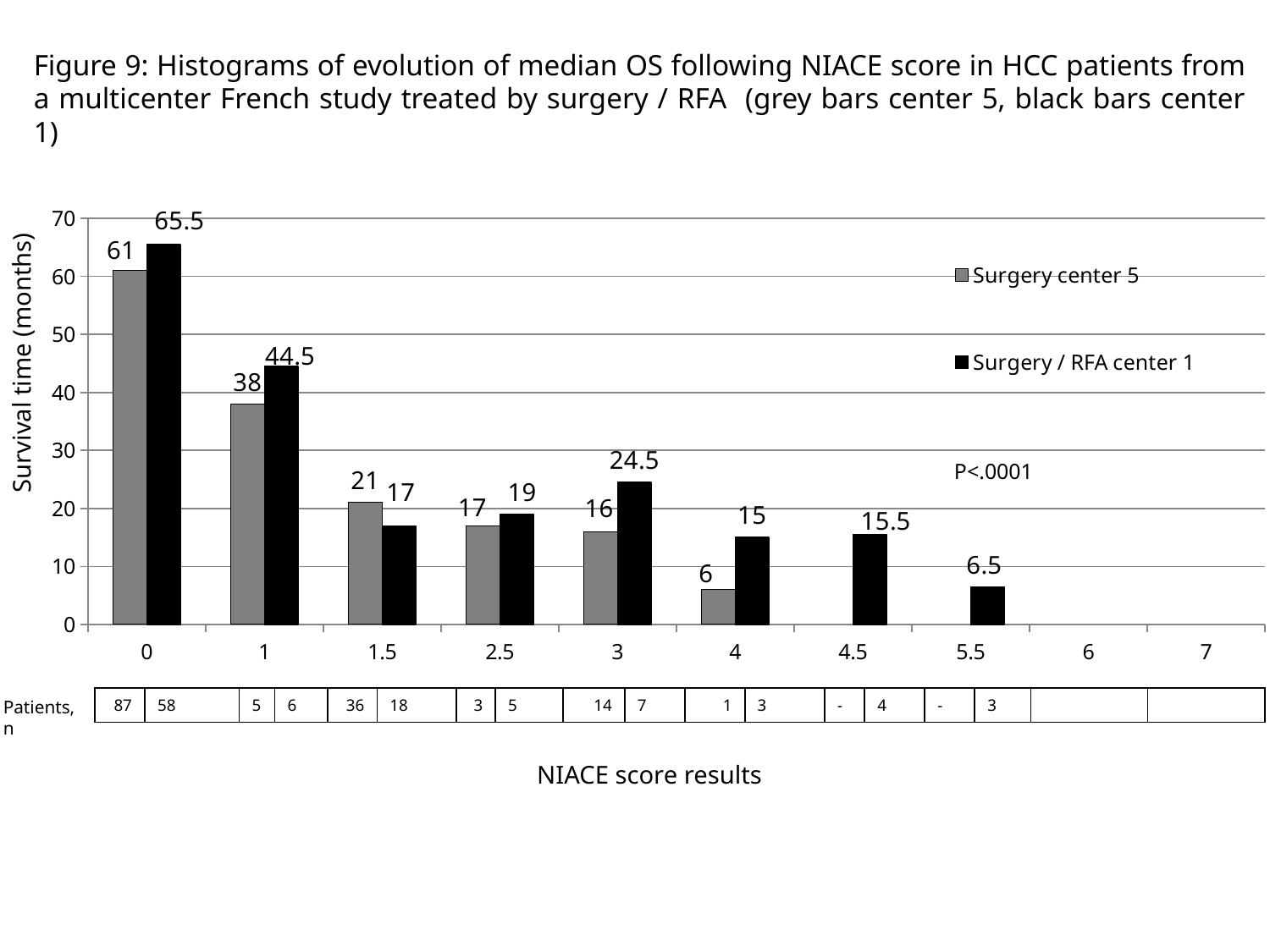
Which NIACE score has the highest survival time for Surgery / RFA center 1? 0 What p-value is shown on the chart? P<.0001 What is the difference between the Surgery / RFA center 1 and Surgery center 5 survival times at NIACE score 3? 8.5 What is the survival time for Surgery / RFA center 1 at NIACE score 1? 44.5 Which NIACE score has the lowest survival time for Surgery center 5? 4 What kind of chart is shown on the slide? Bar chart How many series does the legend list? 2 What is the label of the y axis? Survival time (months) At NIACE score 1.5, which series has the larger survival time, Surgery center 5 or Surgery / RFA center 1? Surgery center 5 Do the Surgery / RFA center 1 survival times generally rise or fall as the NIACE score increases from 0 to 5.5? Fall What is the survival time for Surgery / RFA center 1 at NIACE score 5.5? 6.5 What is the survival time for Surgery center 5 at NIACE score 0? 61